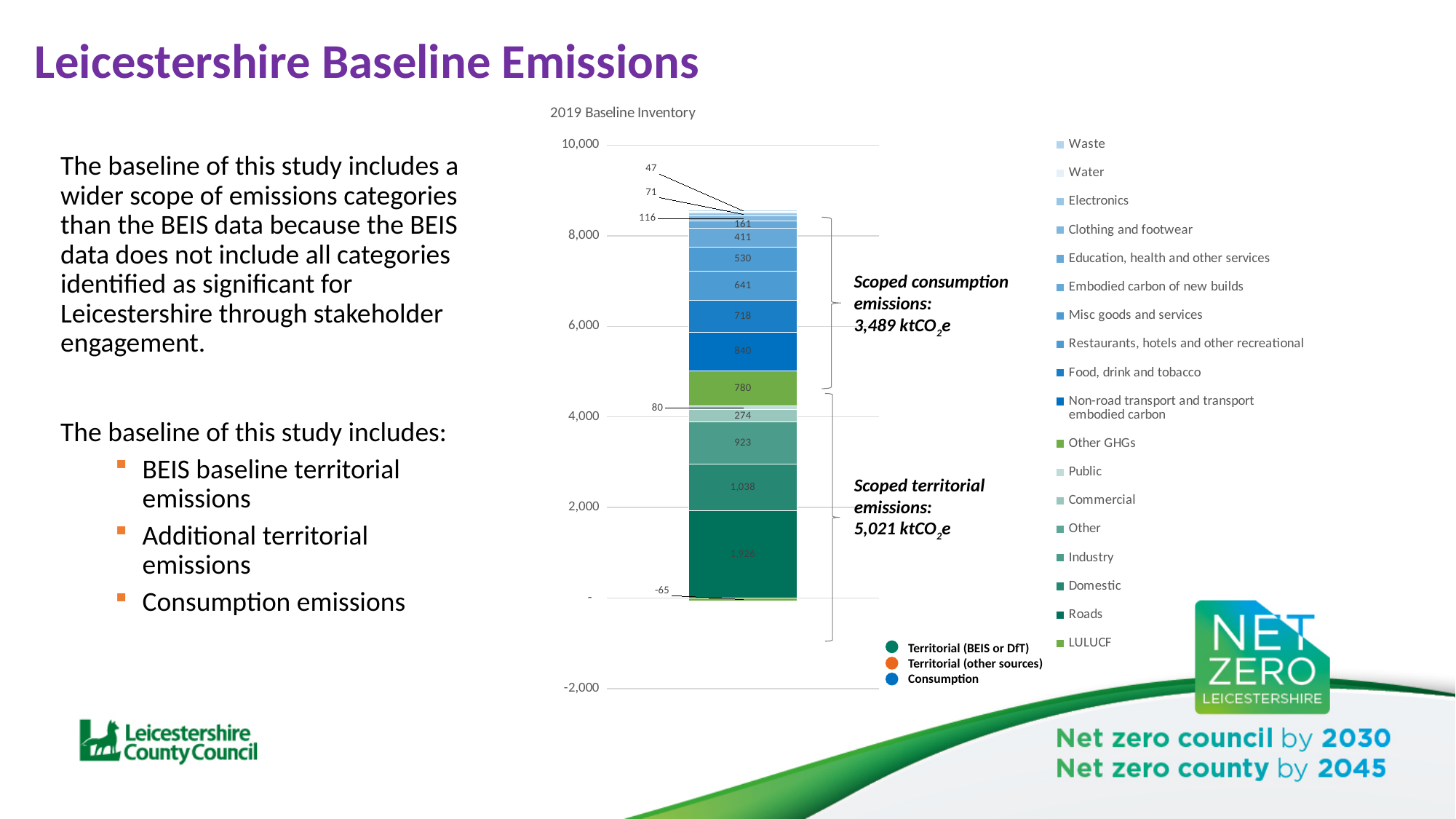
What is the title of the chart? 2019 Baseline Inventory Is the top of the stacked bar greater or less than 8,000? greater What is the smallest positive value labelled on the stacked bar? 47 What is the difference between scoped territorial emissions (5,021) and scoped consumption emissions (3,489)? 1,532 ktCO2e What is the highest value shown on the vertical axis? 10,000 What value is labelled on the segment that extends below zero? -65 What kind of chart is shown on the slide? Stacked bar chart What total is given for scoped territorial emissions? 5,021 ktCO2e What total is given for scoped consumption emissions? 3,489 ktCO2e What value is labelled on the segment directly above the 923 segment? 274 How many entries does the chart's legend list? 18 Which is larger, scoped territorial emissions or scoped consumption emissions? Scoped territorial emissions